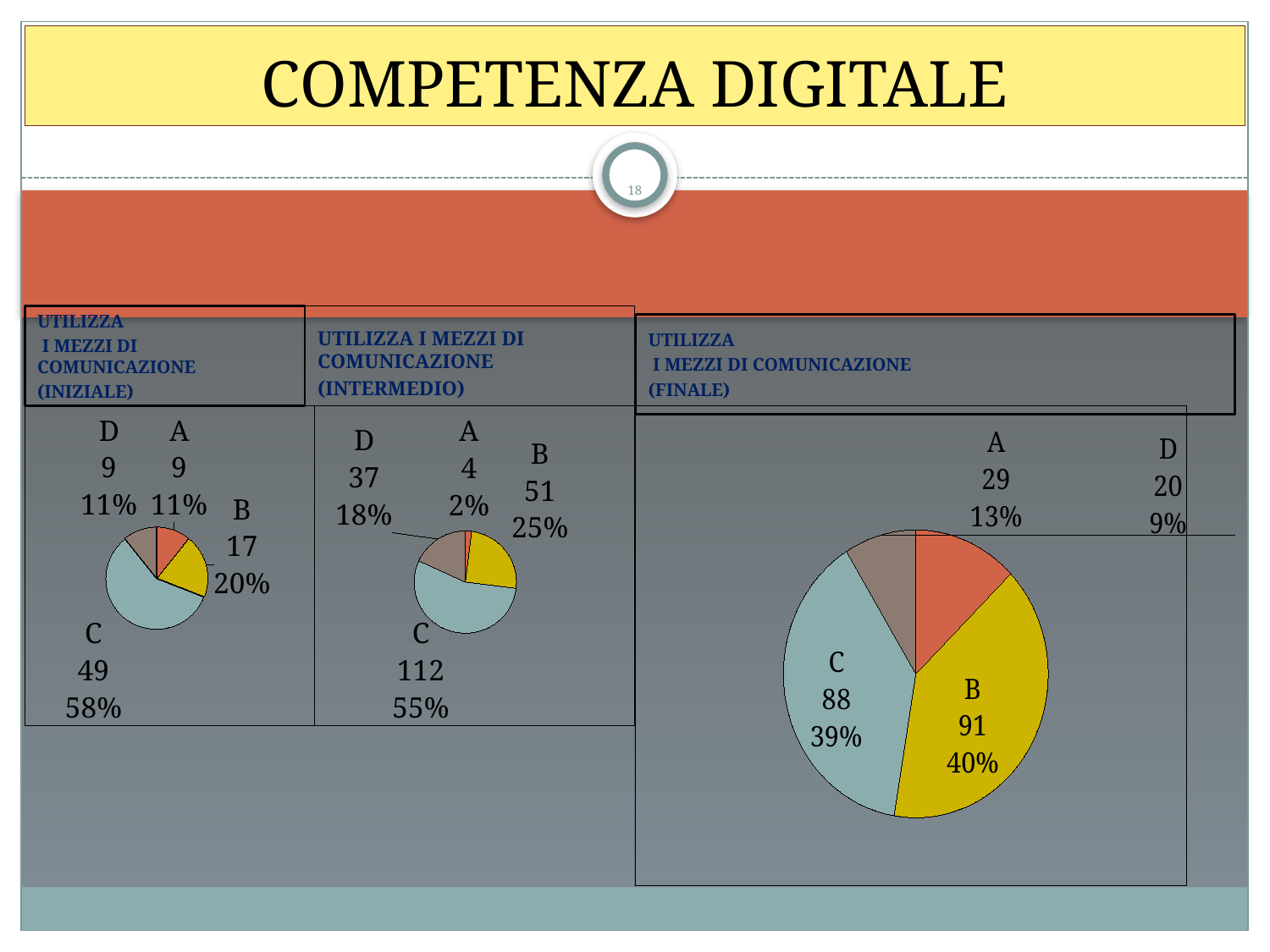
In the INIZIALE pie chart, what is the value for category C? 49 In the INTERMEDIO pie chart, what is the value for category D? 37 In the INIZIALE pie chart, what percentage share does category B have? 20% In the FINALE pie chart, what is the value for category B? 91 In the INTERMEDIO pie chart, which category has the lowest value? A In the FINALE pie chart, what is the difference between the values for B and C? 3 In the INTERMEDIO pie chart, what is the difference between the values for C and B? 61 In the INTERMEDIO pie chart, what percentage share does category C have? 55% What type of chart is used in the FINALE panel? Pie chart In the FINALE pie chart, what percentage share does category A have? 13% How many categories does the INIZIALE pie chart show? 4 In the FINALE pie chart, which category has the lowest value? D